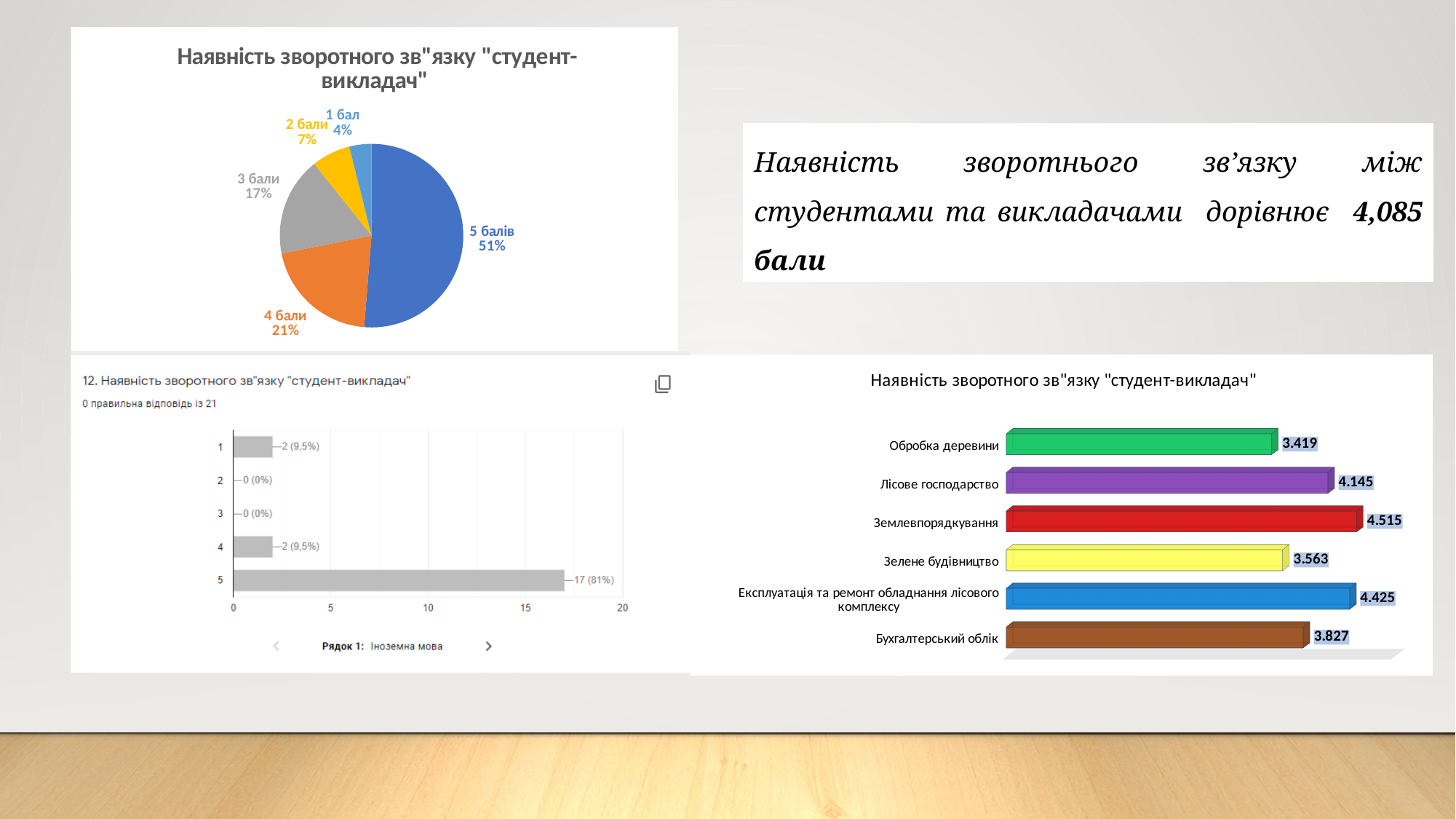
In the pie chart at the top left of the slide, which category has the smallest slice? 1 бал In the bar chart at the bottom right of the slide, what is the value for "Землевпорядкування"? 4.515 In the bar chart at the bottom left of the slide, which option has the highest number of responses? 5 In the pie chart at the top left of the slide, what share of responses is "5 балів"? 51% In the bar chart at the bottom left of the slide, how many responses are shown for option 5? 17 (81%) What type of chart is shown at the bottom right of the slide? Bar chart In the bar chart at the bottom right of the slide, which is larger: "Лісове господарство" or "Бухгалтерський облік"? Лісове господарство In the bar chart at the bottom left of the slide, how many responses are shown for option 1? 2 (9,5%) In the pie chart at the top left of the slide, what percentage is shown for "3 бали"? 17% In the bar chart at the bottom right of the slide, which category has the lowest value? Обробка деревини In the pie chart at the top left of the slide, what is the difference in percentage points between "4 бали" and "2 бали"? 14 In the pie chart at the top left of the slide, how many slices are there? 5